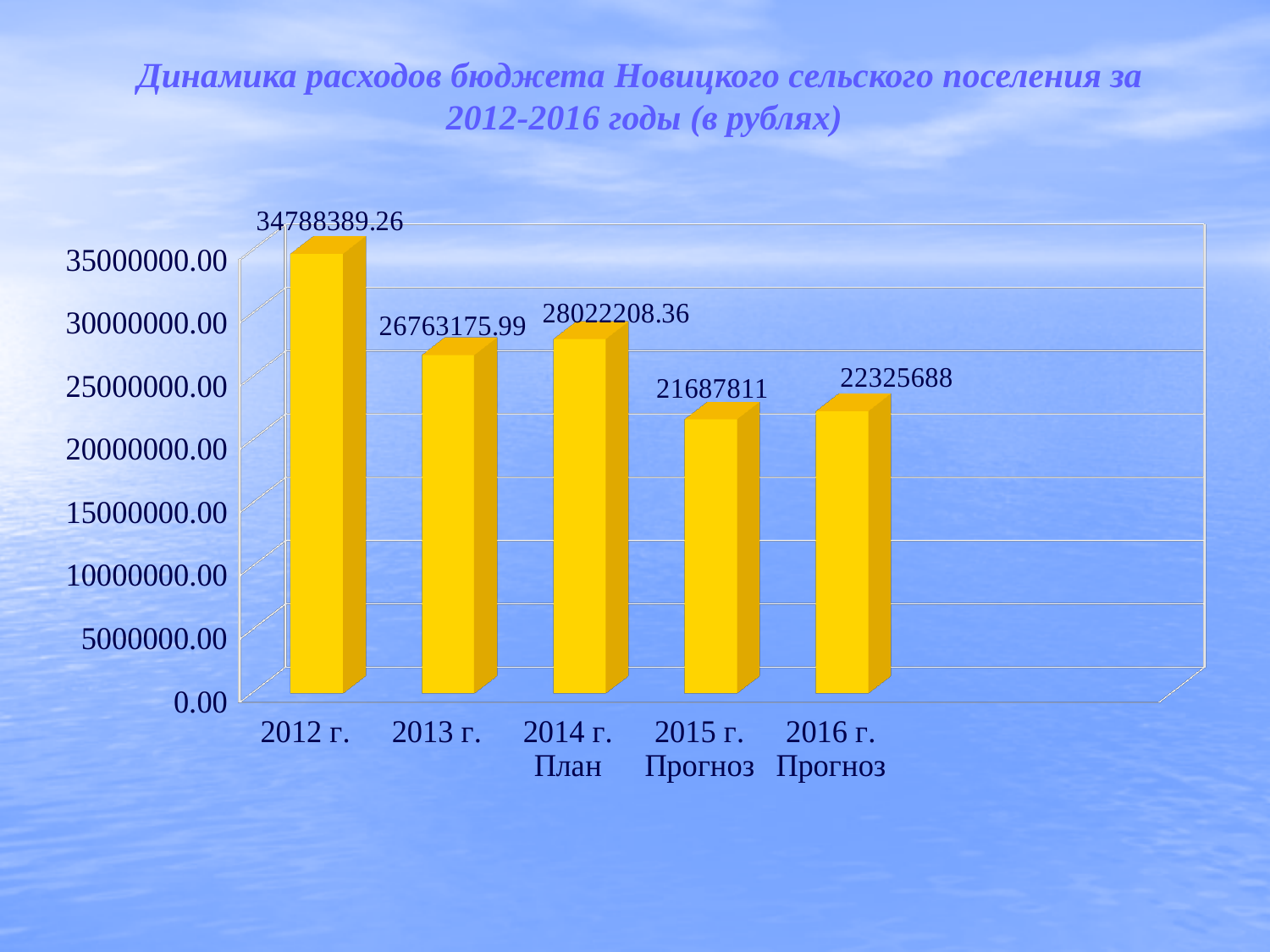
Which year has the lowest value? 2015 г. Прогноз What is the value for 2016 г. Прогноз? 22325688 What is the value for 2013 г.? 26763175.99 Which year has the highest value? 2012 г. What is the value for 2015 г. Прогноз? 21687811 What kind of chart is shown on the slide? Bar chart What is the difference between the values for 2016 г. Прогноз and 2015 г. Прогноз? 637877 Which is larger, the value for 2013 г. or the value for 2014 г. План? 2014 г. План How many categories are shown on the x axis? 5 What is the value for 2014 г. План? 28022208.36 What is the value for 2012 г.? 34788389.26 What is the difference between the values for 2012 г. and 2013 г.? 8025213.27